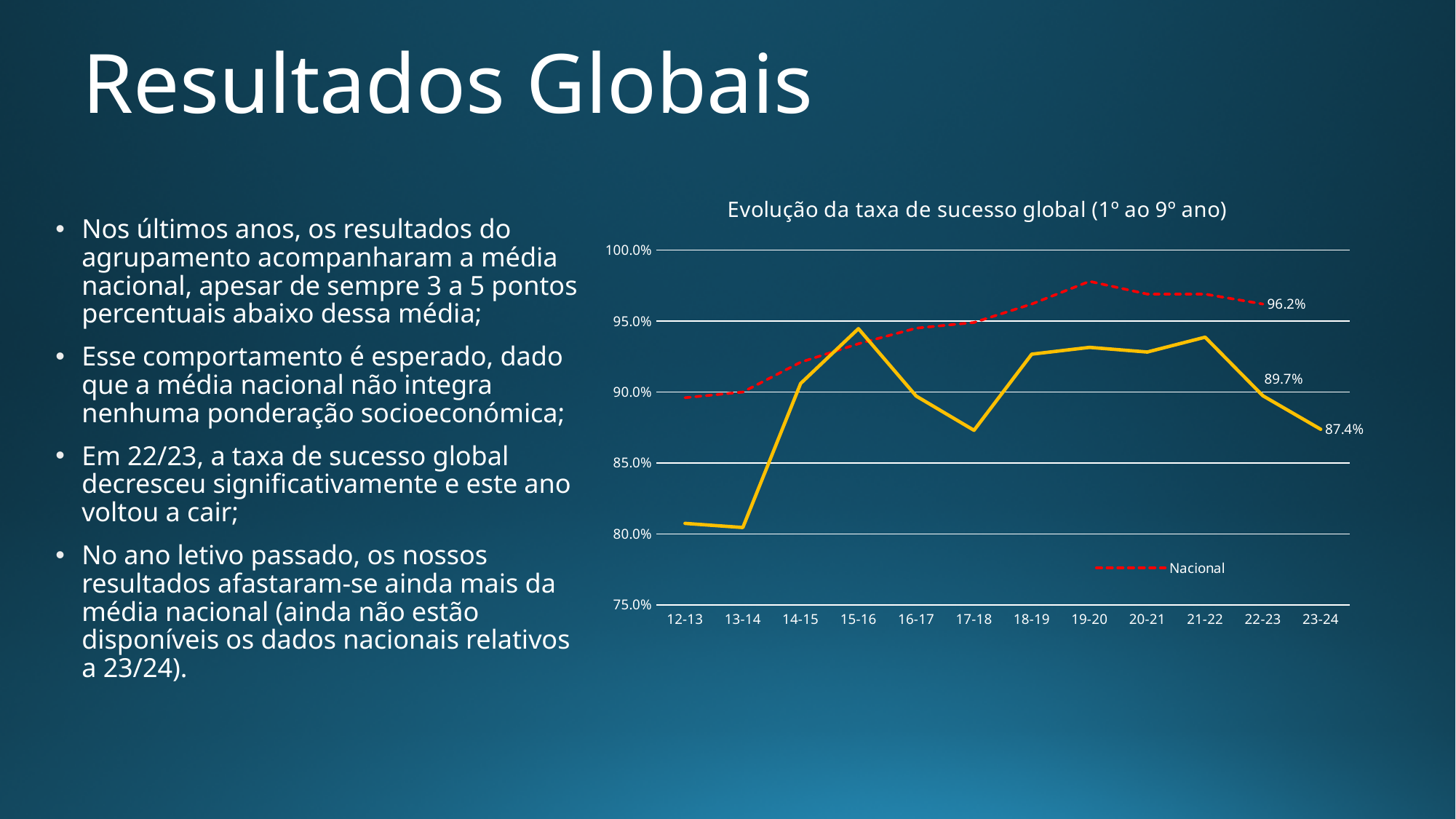
Is the value of the Nacional series in 19-20 greater or less than 95.0%? greater In which school year is the solid yellow line at its lowest? 13-14 In 22-23, how many percentage points higher is the Nacional value than the solid yellow line value? 6.5 Is the value of the solid yellow line in 13-14 greater or less than 85.0%? less What is the value of the Nacional series in 22-23? 96.2% What is the value of the solid yellow line in 22-23? 89.7% How many series does the chart legend list? 1 How many school years are shown on the x axis of the chart? 12 What kind of chart is shown on the slide? line chart What is the value of the solid yellow line in 23-24? 87.4% What is the title of the chart? Evolução da taxa de sucesso global (1º ao 9º ano) By how many percentage points did the solid yellow line fall from 22-23 to 23-24? 2.3